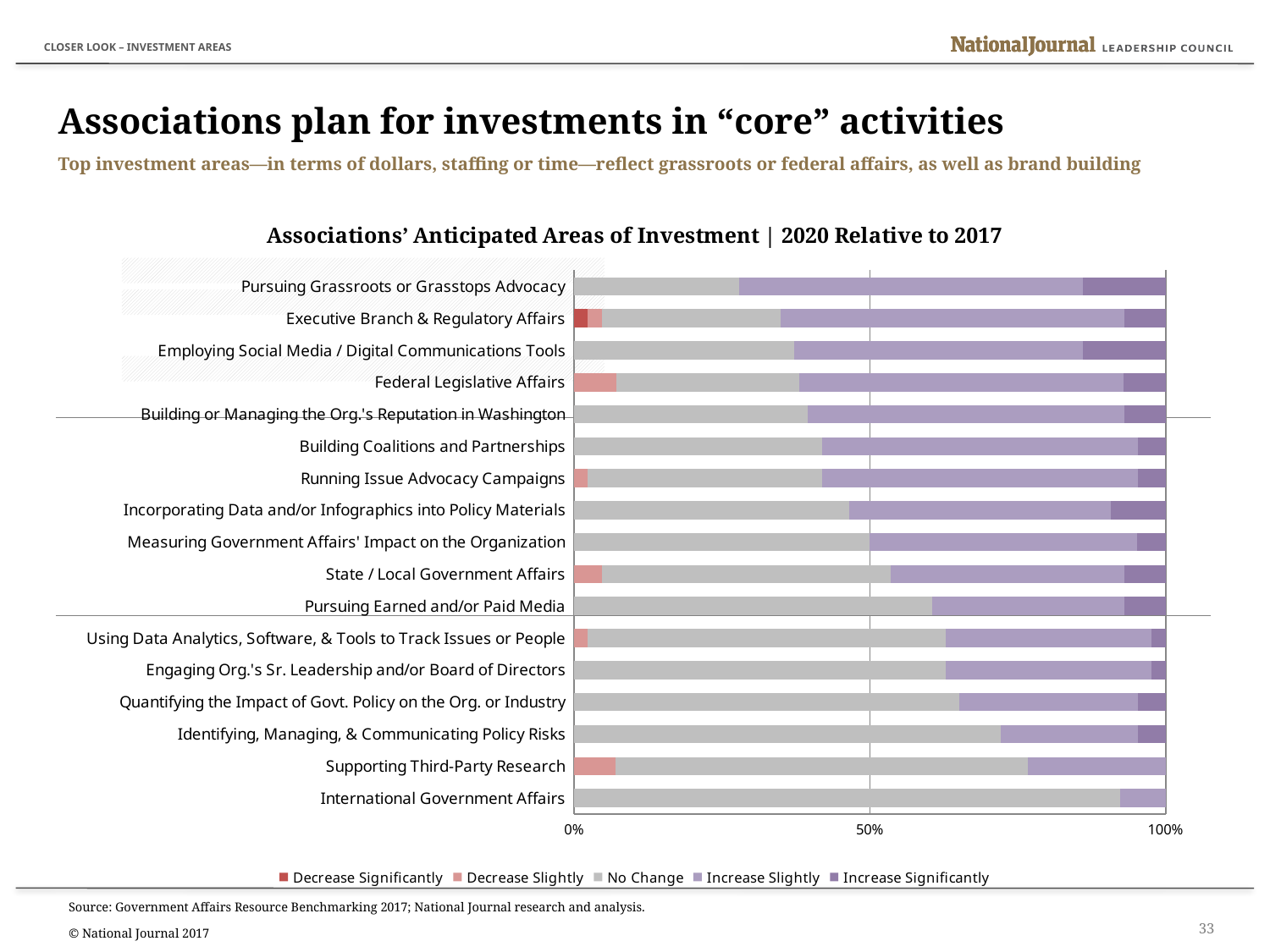
Which category is listed first (at the top) of the chart? Pursuing Grassroots or Grasstops Advocacy Is the No Change share for Supporting Third-Party Research greater or less than 50%? greater Is the No Change share for Pursuing Grassroots or Grasstops Advocacy greater or less than 50%? less How many series does the chart legend list? 5 Is the No Change share for Federal Legislative Affairs greater or less than 50%? less Which category has the largest No Change segment? International Government Affairs What is the title of the chart? Associations' Anticipated Areas of Investment | 2020 Relative to 2017 What value does each stacked bar total to on the x axis? 100% Which has the larger Increase Slightly segment: Pursuing Grassroots or Grasstops Advocacy or International Government Affairs? Pursuing Grassroots or Grasstops Advocacy How many categories (investment areas) are listed on the chart? 17 What kind of chart is shown on the slide? Stacked bar chart